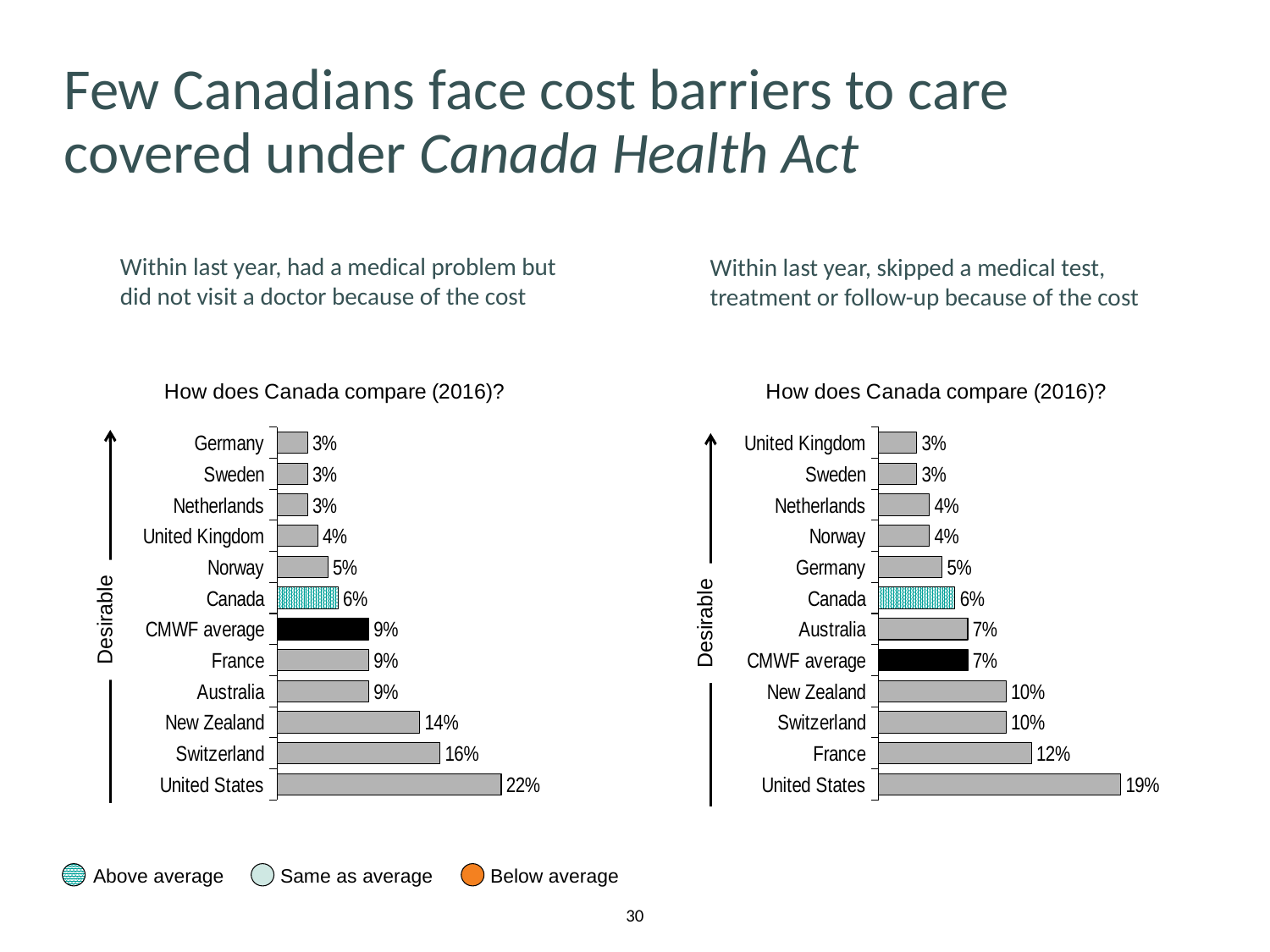
In the left chart (did not visit a doctor because of the cost), which country has the highest value? United States In the right chart (skipped a medical test, treatment or follow-up because of the cost), what is the value for France? 12% In the right chart (skipped a medical test, treatment or follow-up because of the cost), which country has the highest value? United States In the right chart (skipped a medical test, treatment or follow-up because of the cost), which is larger, the value for New Zealand or the value for Germany? New Zealand In the left chart (did not visit a doctor because of the cost), how many bars are shown? 12 In the left chart (did not visit a doctor because of the cost), what is the difference between the United States and Canada? 16% In the left chart (did not visit a doctor because of the cost), what is the CMWF average? 9% What type of chart is used on the left side of the slide? Bar chart In the right chart (skipped a medical test, treatment or follow-up because of the cost), what is the CMWF average? 7% In the left chart (did not visit a doctor because of the cost), what is the value for Canada? 6% In the right chart (skipped a medical test, treatment or follow-up because of the cost), what is the difference between the United States and the CMWF average? 12% In the left chart (did not visit a doctor because of the cost), what is the value for Switzerland? 16%